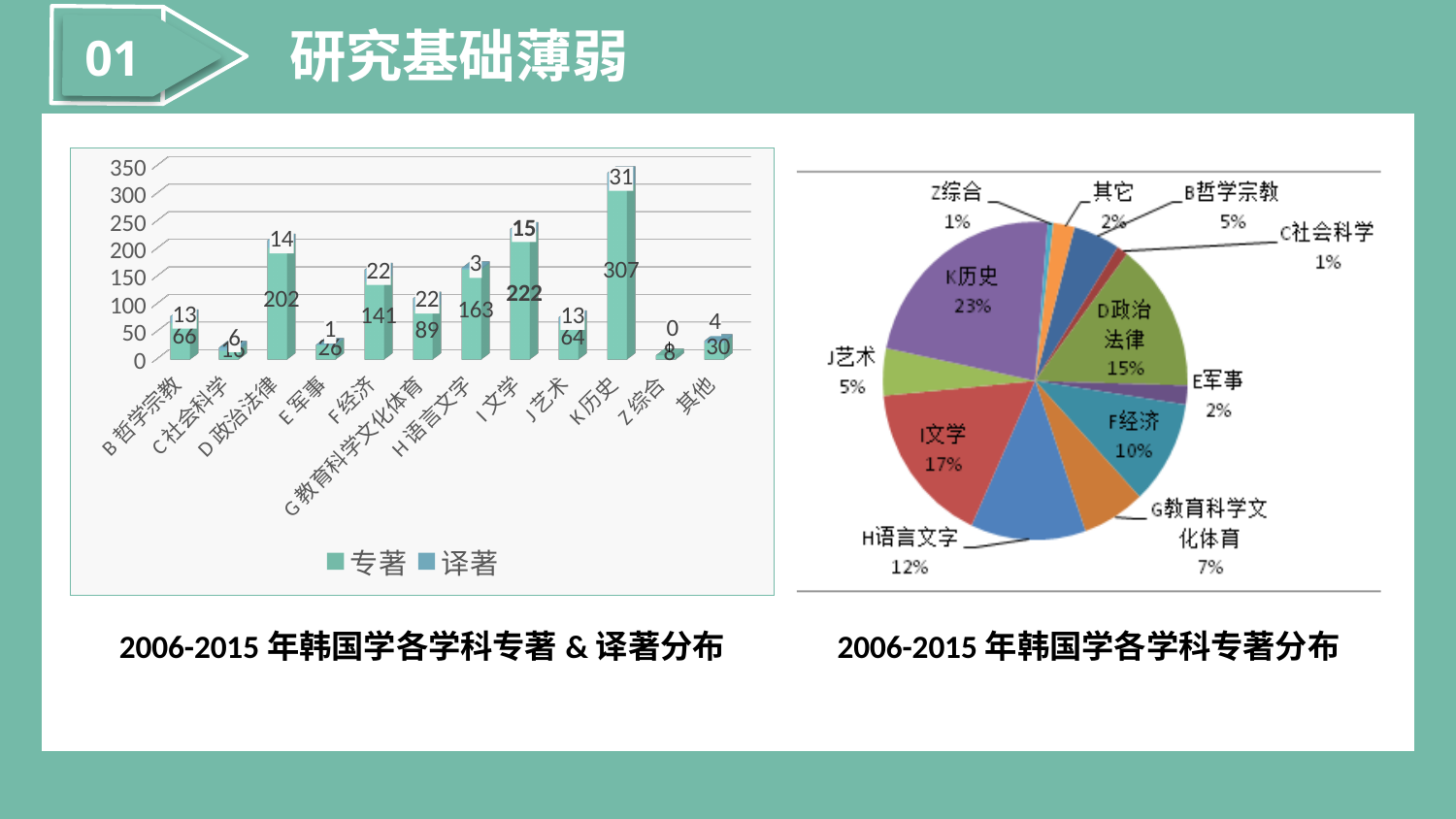
In the bar chart on the left, which is larger: the 专著 value for H语言文字 or for F经济? H语言文字 In the bar chart on the left, which category has the lowest 译著 value? Z综合 In the bar chart on the left, what is the difference between the 专著 values for I文学 and D政治法律? 20 In the bar chart on the left, how many categories are shown on the x axis? 12 In the bar chart on the left, what is the 专著 value for K历史? 307 In the pie chart on the right, which slice is the largest? K历史 In the pie chart on the right, what share does K历史 have? 23% In the bar chart on the left, how many series does the legend list? 2 In the bar chart on the left, what is the 译著 value for F经济? 22 What is the title of the chart on the right? 2006-2015 年韩国学各学科专著分布 In the bar chart on the left, which category has the highest 专著 value? K历史 What kind of chart is the chart on the left? bar chart